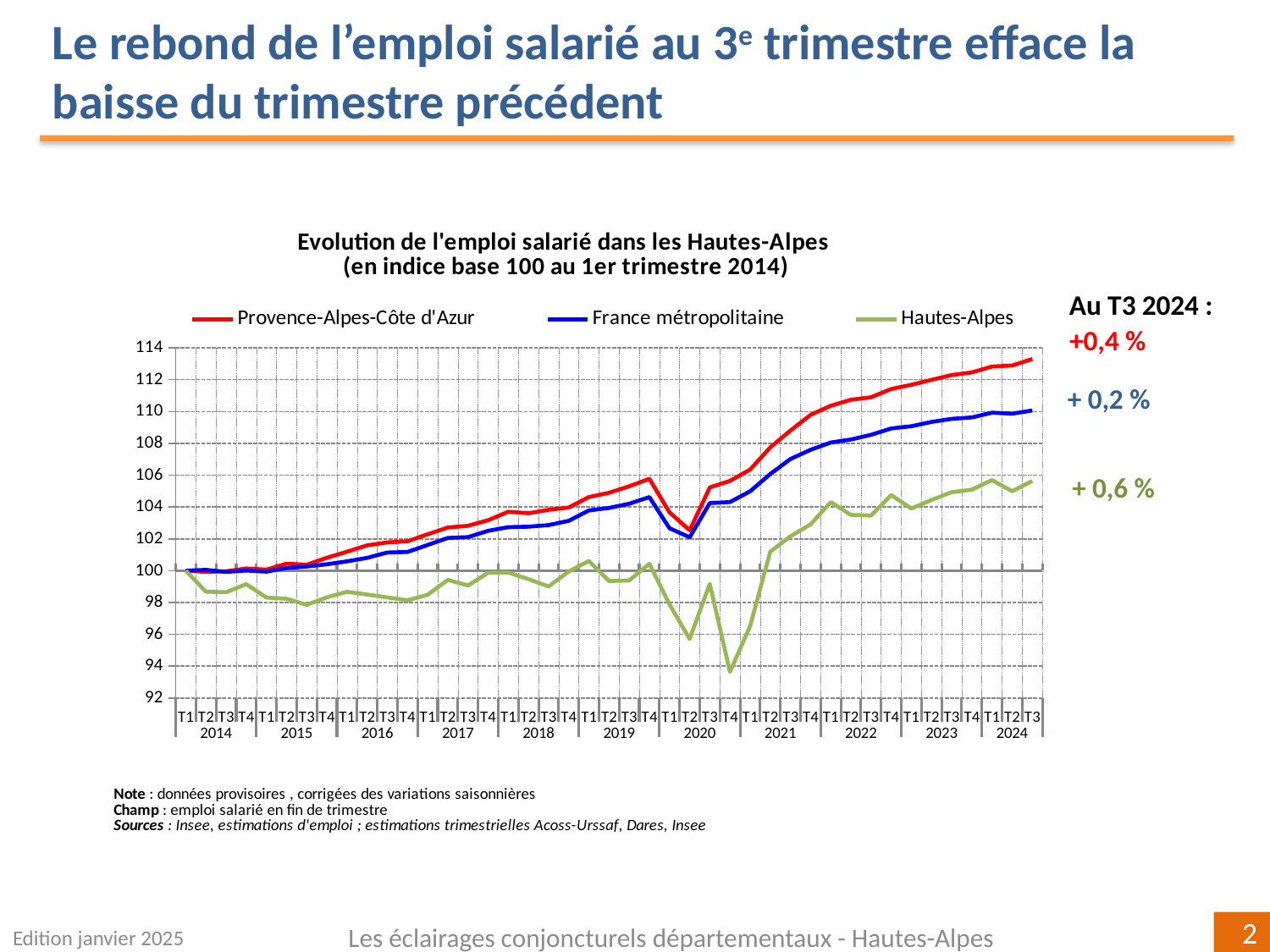
Is the value for Hautes-Alpes at T3 2024 greater or less than 104? greater Which series has the highest value at T3 2024? Provence-Alpes-Côte d'Azur Does the Provence-Alpes-Côte d'Azur series rise or fall overall from T1 2014 to T3 2024? rise What quarterly change is annotated for Hautes-Alpes at T3 2024? + 0,6 % How many series does the legend list? 3 At T4 2020, which is larger: France métropolitaine or Hautes-Alpes? France métropolitaine What kind of chart is shown on the slide? line chart Which series has the lowest value at T3 2024? Hautes-Alpes Is the value for Provence-Alpes-Côte d'Azur at T3 2024 greater or less than 112? greater Is the value for France métropolitaine at T3 2024 greater or less than 108? greater What is the base of the index used in the chart, according to the chart title? base 100 au 1er trimestre 2014